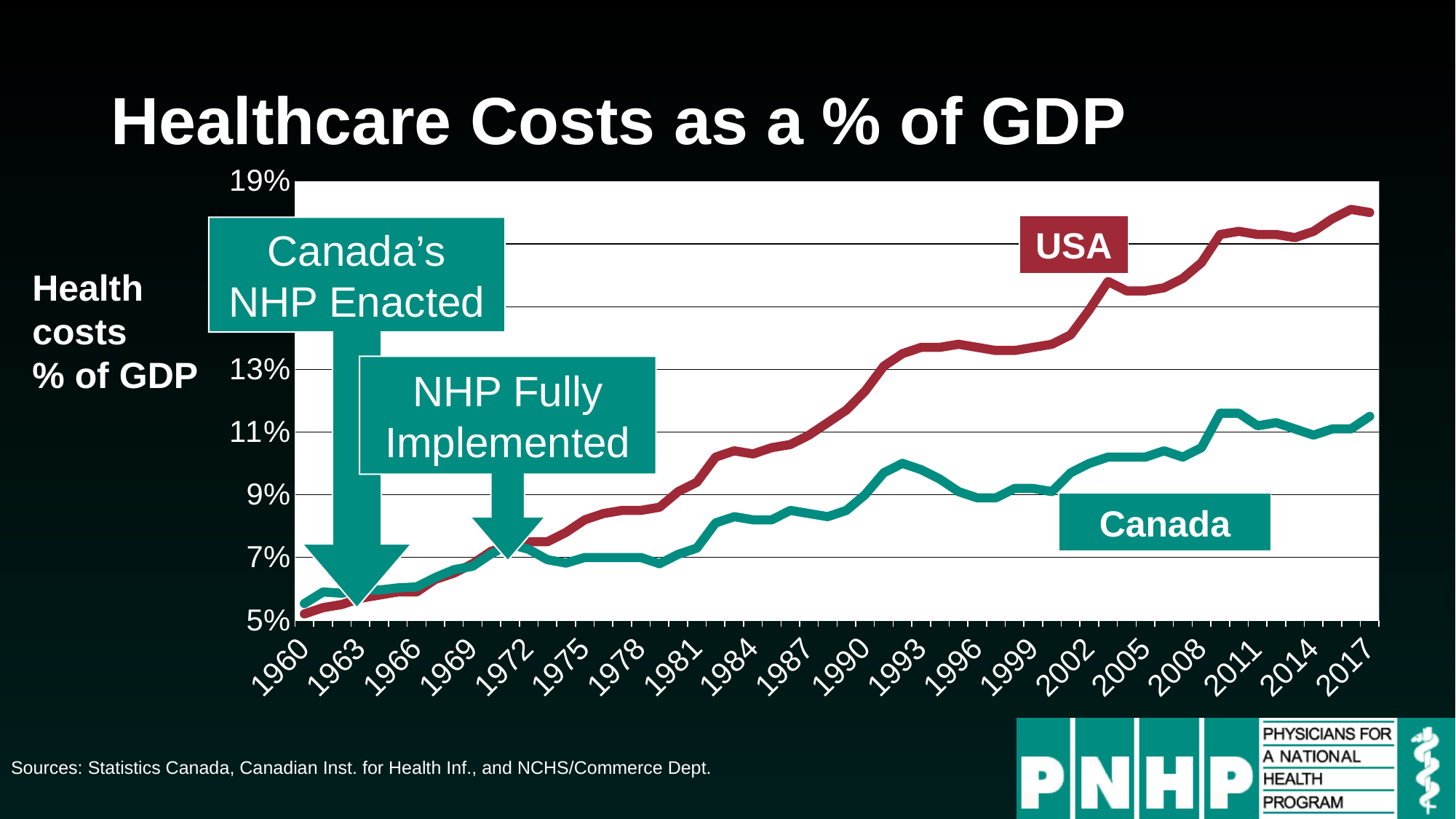
How many series are plotted on the chart? 2 What label is shown on the vertical axis of the chart? Health costs % of GDP Which series reaches the highest value on the chart? USA Is the value for Canada in 2017 greater or less than 13%? less Does the USA series generally rise or fall from 1960 to 2017? rise Is the value for USA in 2002 greater or less than 13%? greater What kind of chart is shown on the slide? line chart Is the value for USA in 2017 greater or less than 17%? greater What is the title of the chart? Healthcare Costs as a % of GDP Which series is higher in 2017, USA or Canada? USA